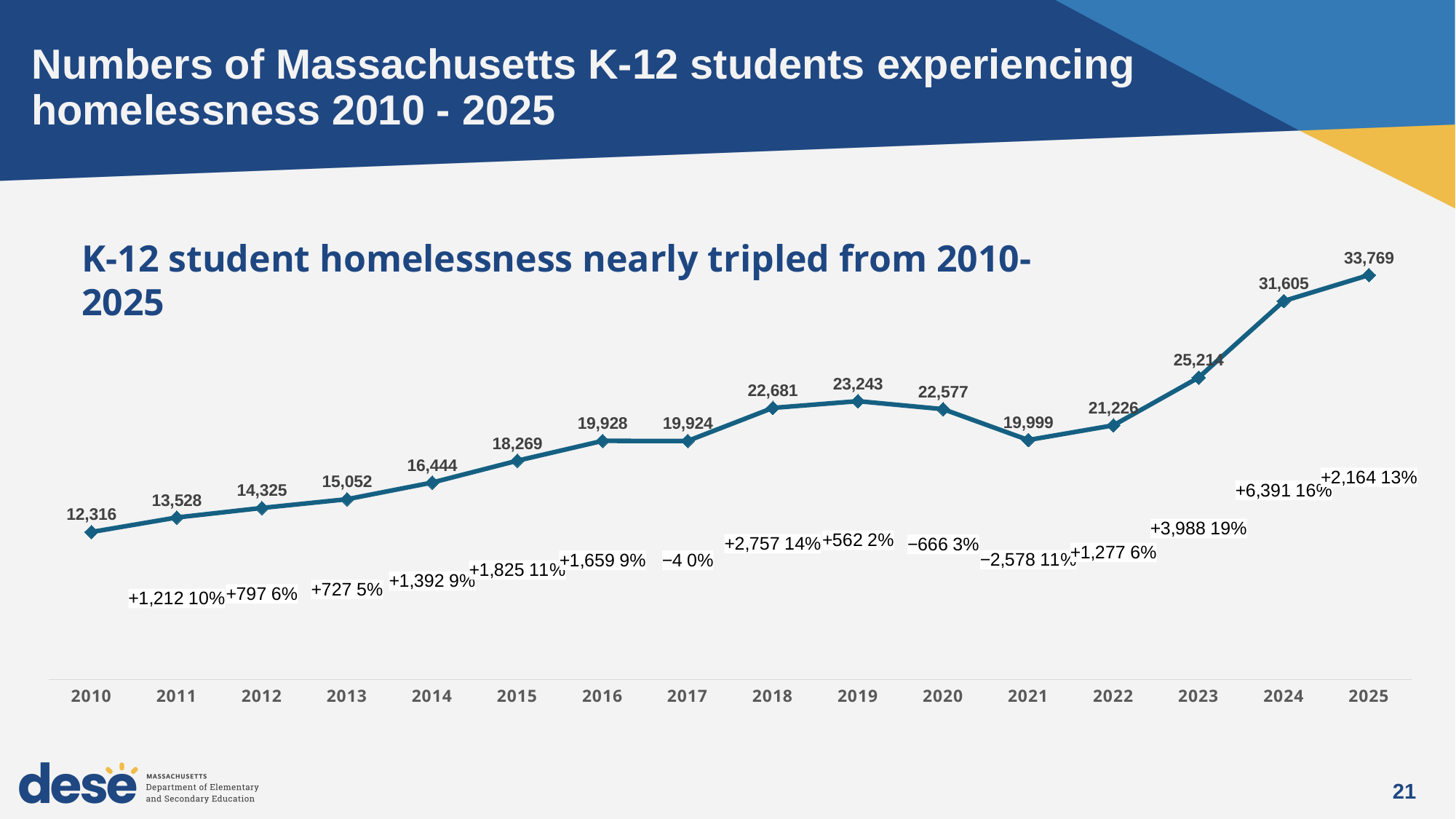
Which year has the lowest number of students experiencing homelessness? 2010 What is the value plotted for 2021? 19,999 How many years are plotted on the chart? 16 What is the chart's title? K-12 student homelessness nearly tripled from 2010-2025 What is the difference between the 2024 value and the 2023 value? 6,391 Which year has the highest number of students experiencing homelessness? 2025 What is the value plotted for 2019? 23,243 What is the difference between the 2025 value and the 2010 value? 21,453 Which year has a larger value, 2018 or 2020? 2018 What is the number of K-12 students experiencing homelessness in 2010? 12,316 What kind of chart is shown on the slide? Line chart What is the number of K-12 students experiencing homelessness in 2025? 33,769